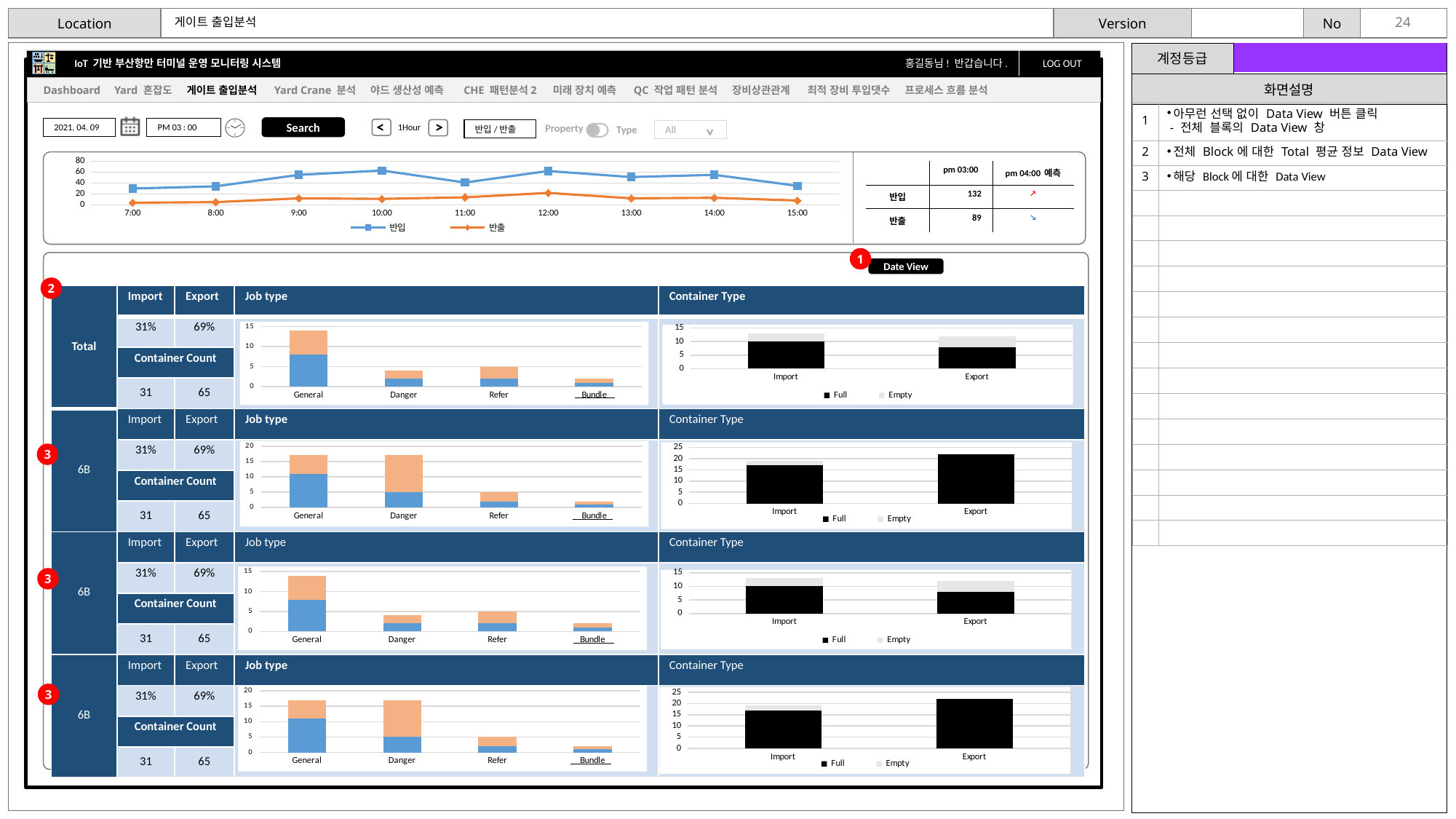
In the Job type chart of the Total row, which category has the shortest stacked bar? Bundle In the top line chart, is the 반입 value at 12:00 greater or less than 40? greater In the top line chart, at which time is the 반출 value highest? 12:00 How many series does the legend of the top line chart list? 2 What kind of chart is the chart at the top of the dashboard showing 반입 and 반출 over time? line chart In the Container Type chart of the second row (first 6B block), is the Export bar greater or less than 20? greater How many categories are shown on the x axis of the Job type chart in the Total row? 4 In the Container Type chart of the second row (first 6B block), which bar is taller, Import or Export? Export In the top line chart, which series has the larger value at 12:00, 반입 or 반출? 반입 In the top line chart, is the 반출 value at 7:00 greater or less than 20? less In the Job type chart of the Total row, which category has the tallest stacked bar? General How many time points are plotted along the x axis of the top line chart? 9